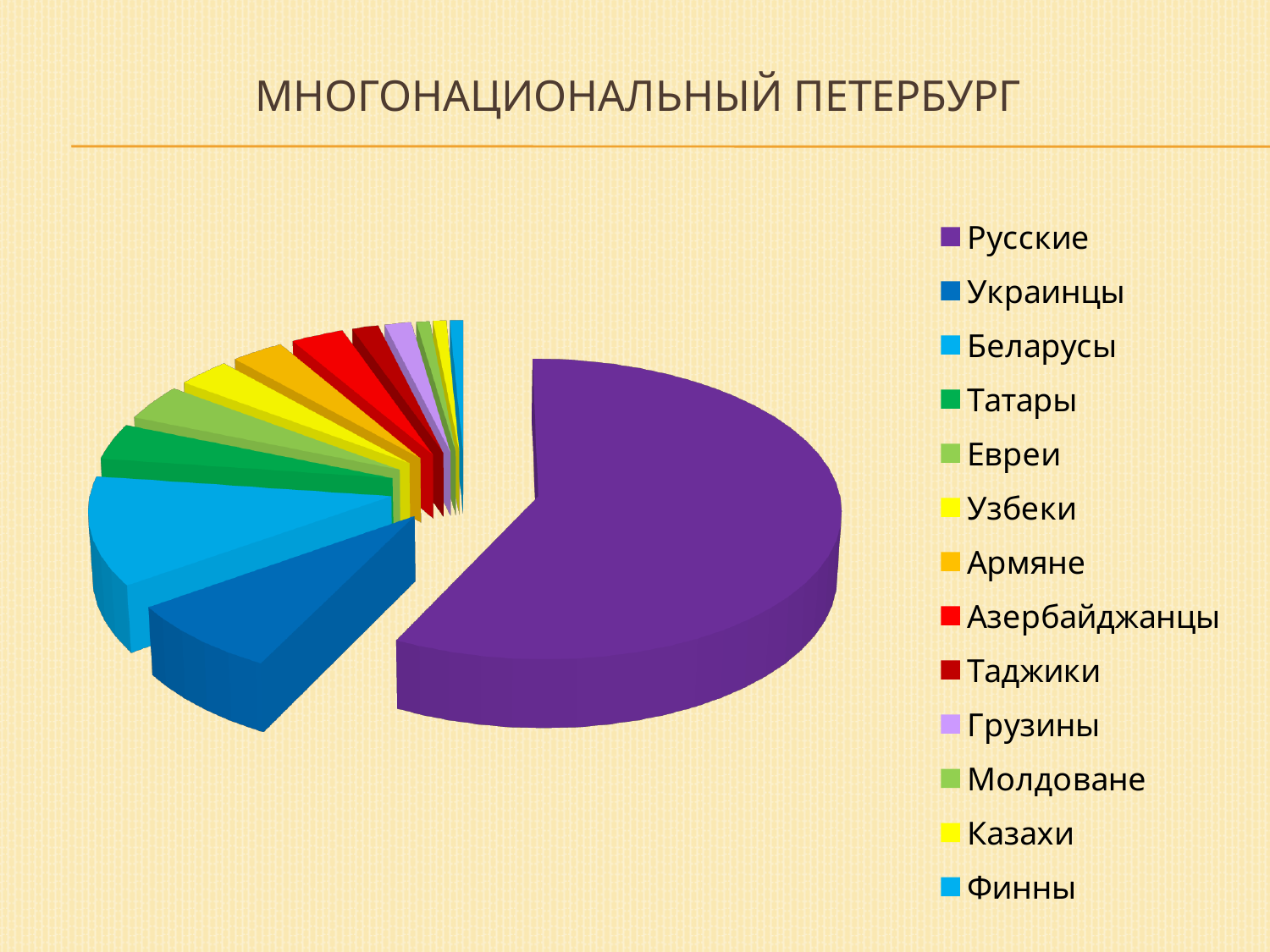
Which slice is larger, Беларусы or Финны? Беларусы Which category is listed first in the legend of the pie chart? Русские How many categories does the legend of the pie chart list? 13 Which slice is larger, Украинцы or Татары? Украинцы Which category is shown in purple on the pie chart? Русские What is the title of the slide with the pie chart? МНОГОНАЦИОНАЛЬНЫЙ ПЕТЕРБУРГ Which category has the largest slice of the pie chart? Русские What kind of chart is shown on the slide? pie chart Which slice is larger, Беларусы or Армяне? Беларусы